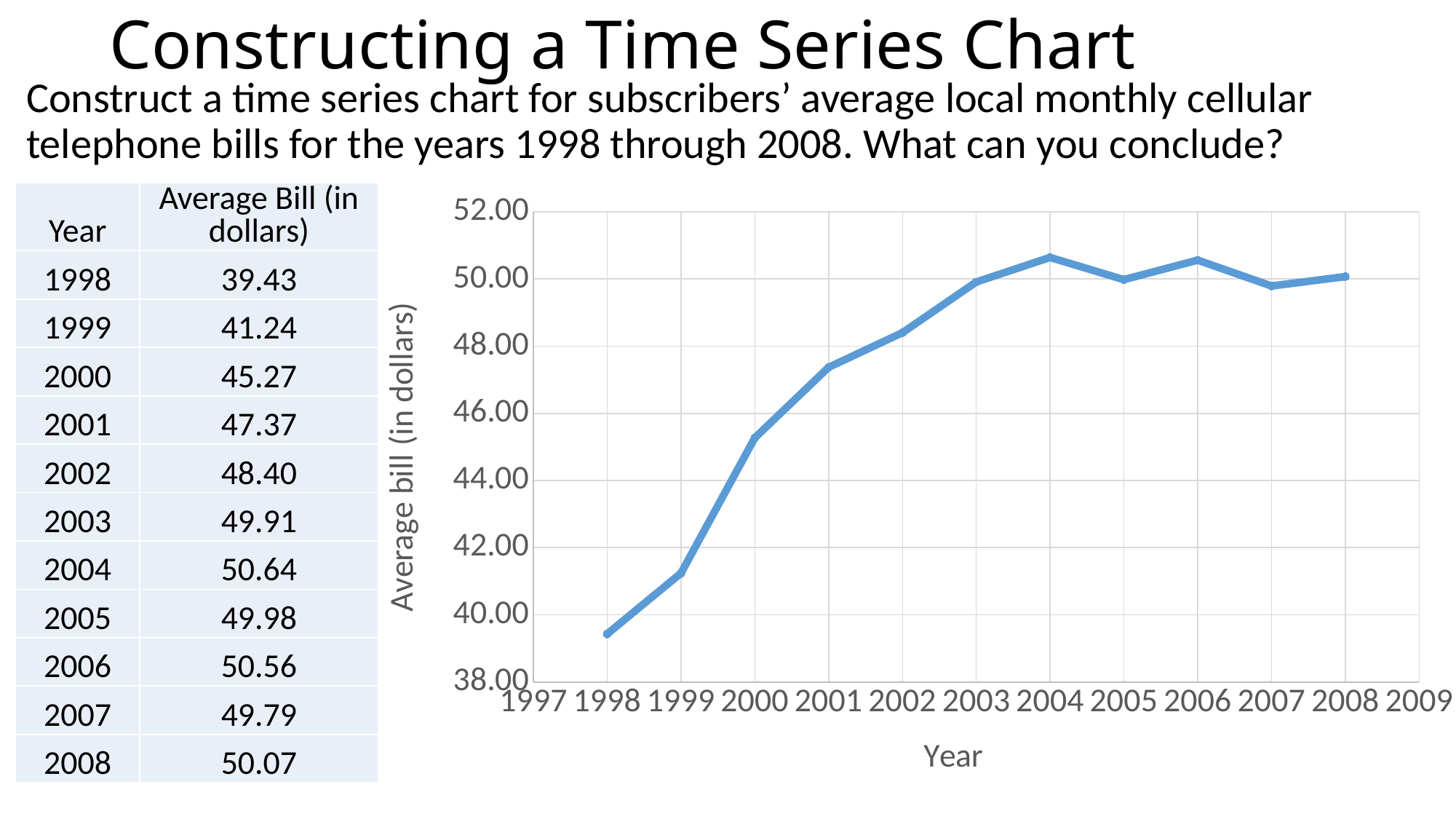
What is the difference between the average bill in 2008 and in 1998? 10.64 Is the value for 1999 greater or less than 42.00? less What is the label of the vertical axis of the chart? Average bill (in dollars) Which year has a larger average bill, 2000 or 2003? 2003 What is the average bill for 2004 according to the slide? 50.64 What is the average bill for 1998 according to the slide? 39.43 Which year has the lowest average bill? 1998 How many years are plotted on the chart? 11 Is the value for 2001 greater or less than 46.00? greater What type of chart is shown on the slide? line chart Which year has the highest average bill? 2004 Does the average bill generally rise or fall from 1998 to 2003? rise